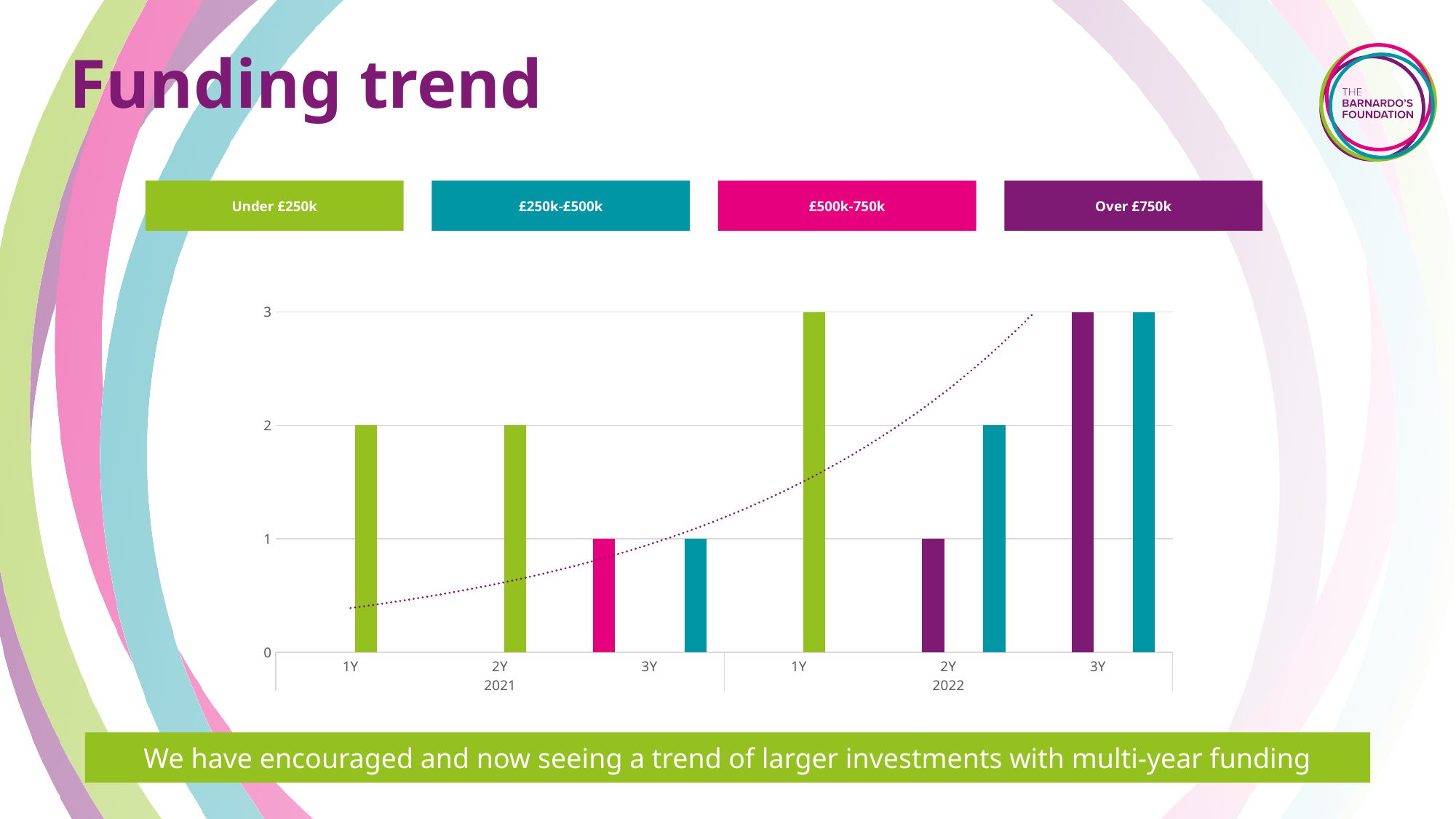
What is the value of the Under £250k bar for 1Y in 2021? 2 How many year-length categories (1Y, 2Y, 3Y) are shown on the x axis in total across both years? 6 What is the value of the £500k-750k bar for 3Y in 2021? 1 What is the value of the Over £750k bar for 3Y in 2022? 3 Which is larger: the Over £750k bar for 2Y in 2022 or the Over £750k bar for 3Y in 2022? 3Y in 2022 What is the value of the £250k-£500k bar for 2Y in 2022? 2 Does the dotted trend line rise or fall from left to right? Rises What colour represents the £500k-750k funding band? Pink How many funding bands does the legend list? 4 What kind of chart is shown on the slide? Bar chart